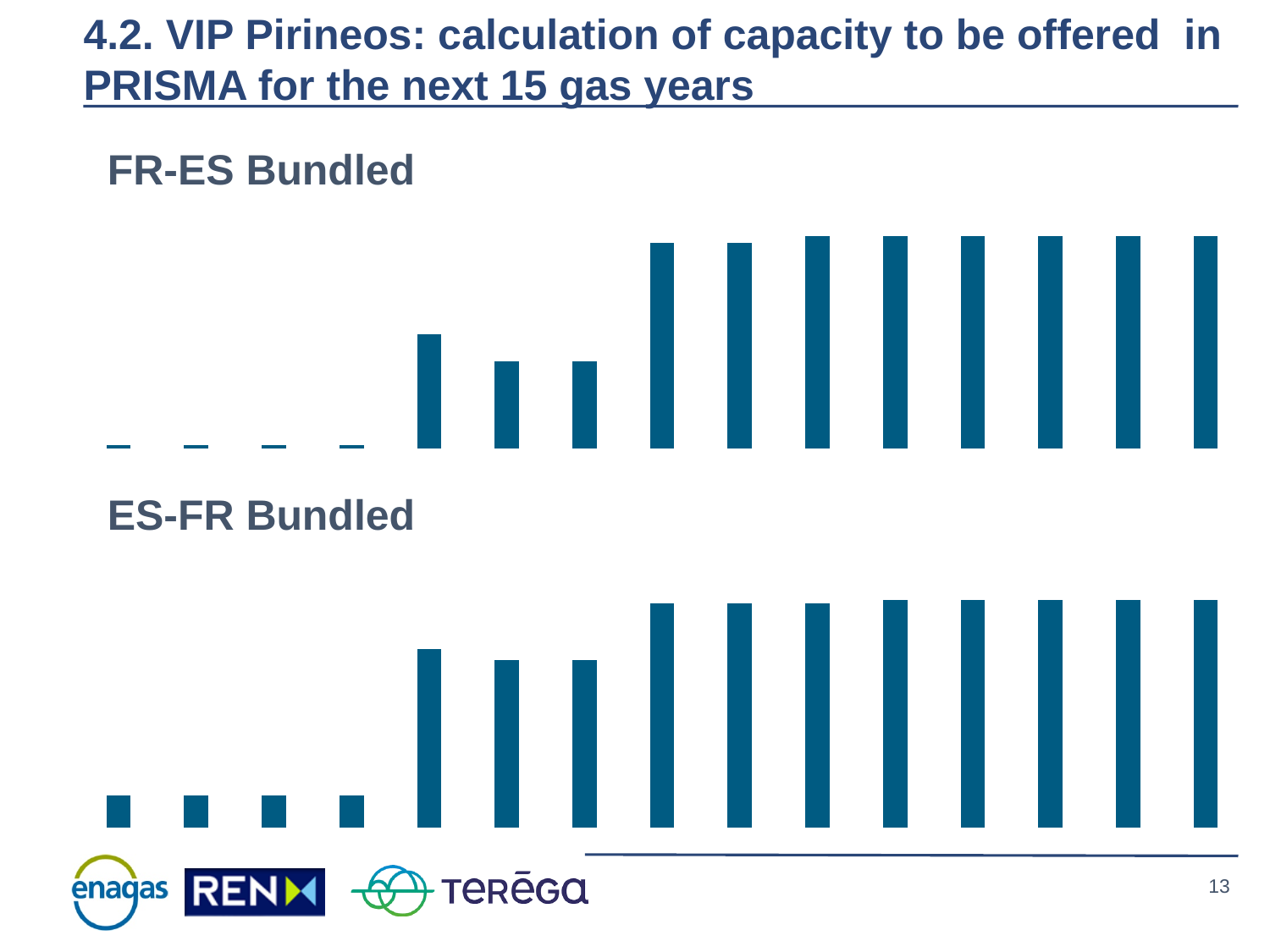
In the FR-ES Bundled chart, is the first bar on the left larger or smaller than the last bar on the right? smaller In the ES-FR Bundled chart, is the fifth bar from the left larger or smaller than the sixth bar from the left? larger In the FR-ES Bundled chart, do the bar values generally rise or fall from left to right? rise How many bars are plotted in the ES-FR Bundled chart? 15 What is the title of the upper chart on the slide? FR-ES Bundled What kind of chart is the ES-FR Bundled chart? bar chart What is the title of the lower chart on the slide? ES-FR Bundled What kind of chart is the FR-ES Bundled chart? bar chart How many bars are plotted in the FR-ES Bundled chart? 15 In the ES-FR Bundled chart, do the bar values generally rise or fall from left to right? rise